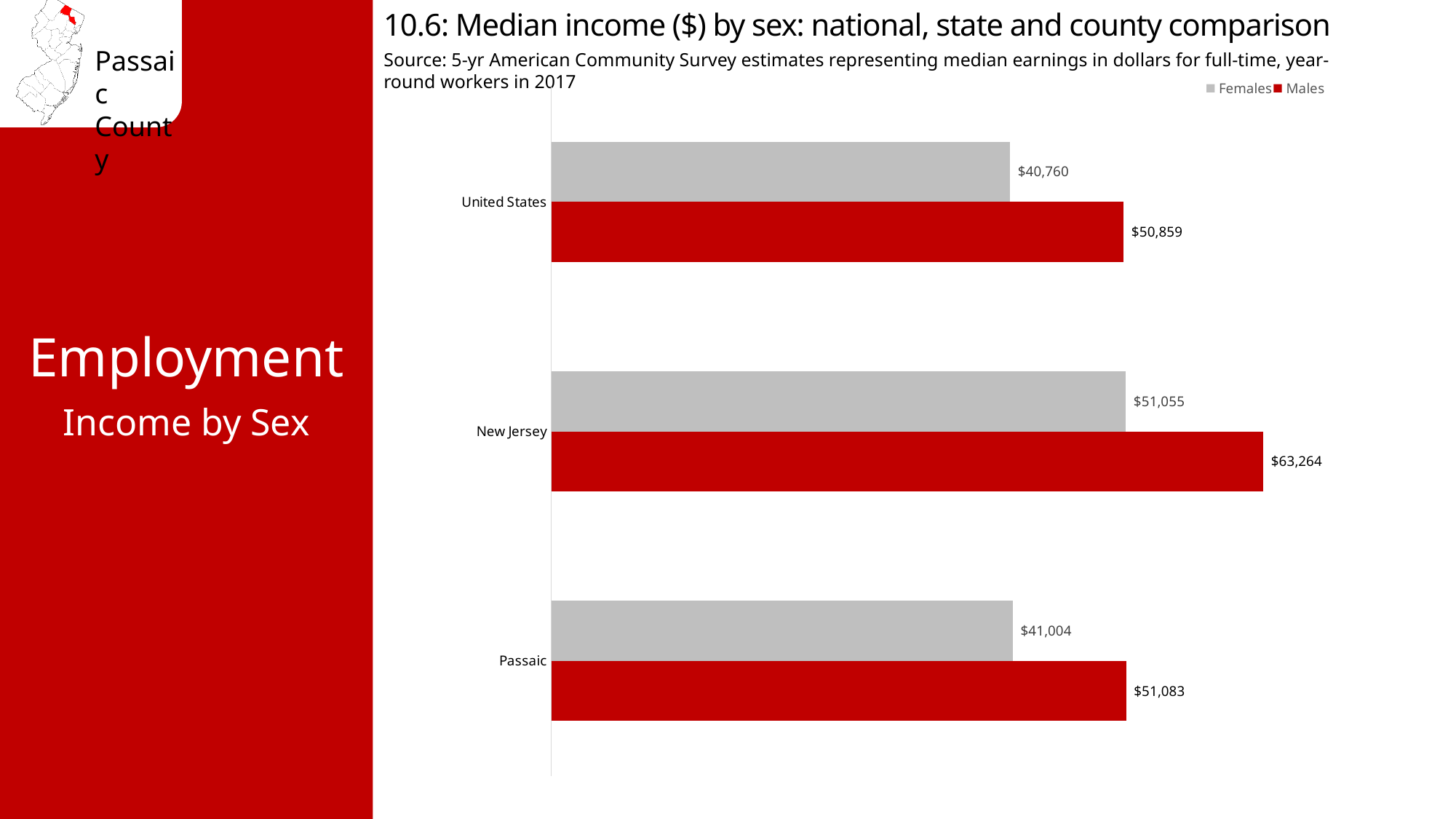
How many series does the legend list? 2 What is the difference between male and female median income in Passaic? $10,079 What is the median income for females in Passaic? $41,004 Which geography has the highest median income for males? New Jersey How many geographies are shown on the chart? 3 What is the difference between male and female median income in New Jersey? $12,209 Which geography has the lowest median income for females? United States What is the median income for males in Passaic? $51,083 What is the median income for females in the United States? $40,760 Which is larger: the median income for females in New Jersey or for males in the United States? Females in New Jersey What is the median income for males in New Jersey? $63,264 What kind of chart is shown on the slide? Bar chart